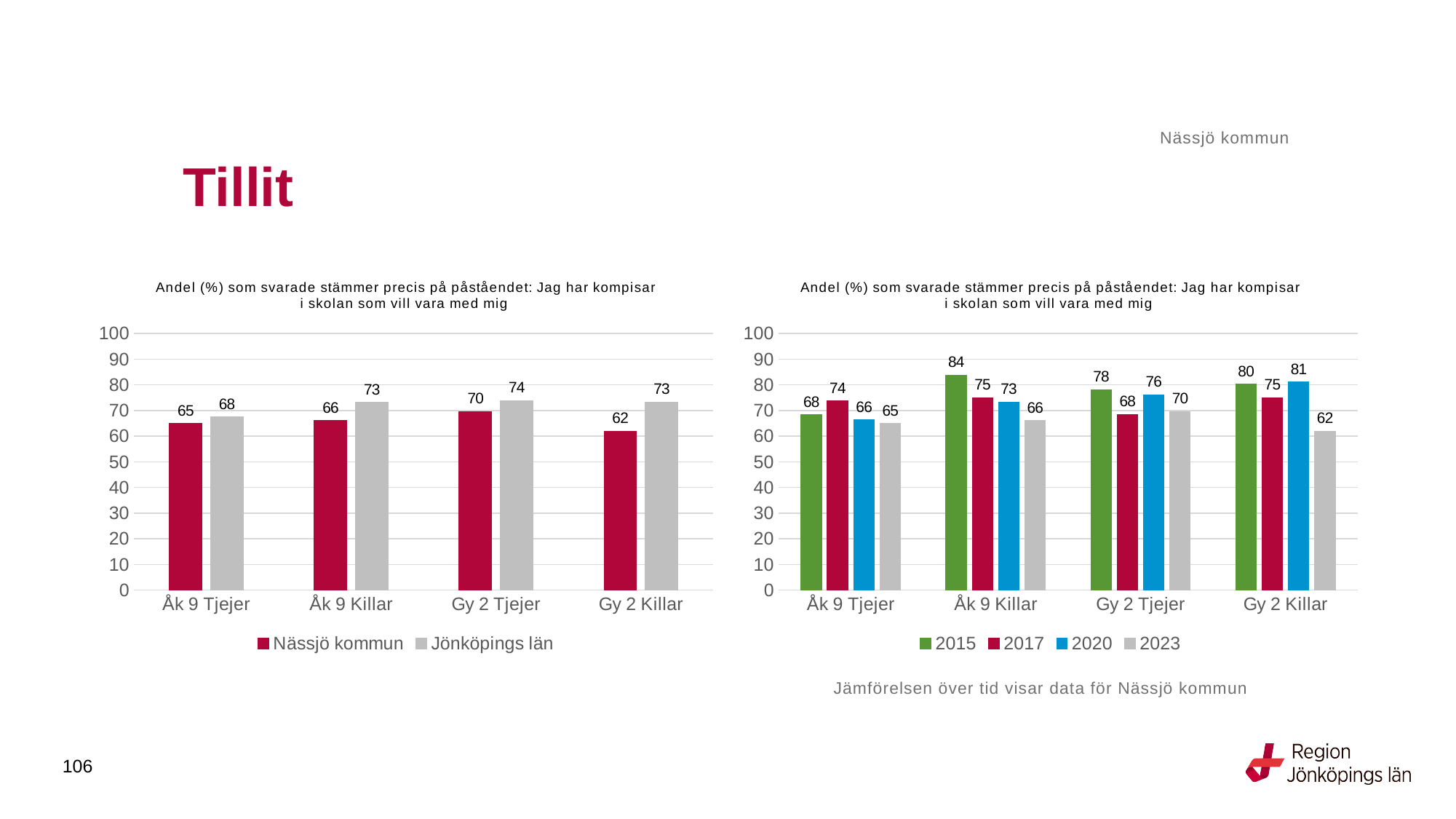
In the right chart, which year has the highest value for Gy 2 Tjejer? 2015 In the left chart, how many series does the legend list? 2 In the right chart, how many series does the legend list? 4 In the left chart, which category has the lowest value for Nässjö kommun? Gy 2 Killar In the left chart, what is the value for Nässjö kommun for Gy 2 Tjejer? 70 In the right chart, what is the value for 2020 for Gy 2 Killar? 81 In the right chart, what is the value for 2015 for Åk 9 Killar? 84 What kind of chart is the left chart? Bar chart In the right chart, which is larger for Åk 9 Tjejer: the value for 2017 or the value for 2023? 2017 In the right chart, what is the difference between the 2015 and 2023 values for Gy 2 Killar? 18 In the left chart, what is the value for Jönköpings län for Åk 9 Killar? 73 In the left chart, what is the difference between Jönköpings län and Nässjö kommun for Gy 2 Killar? 11